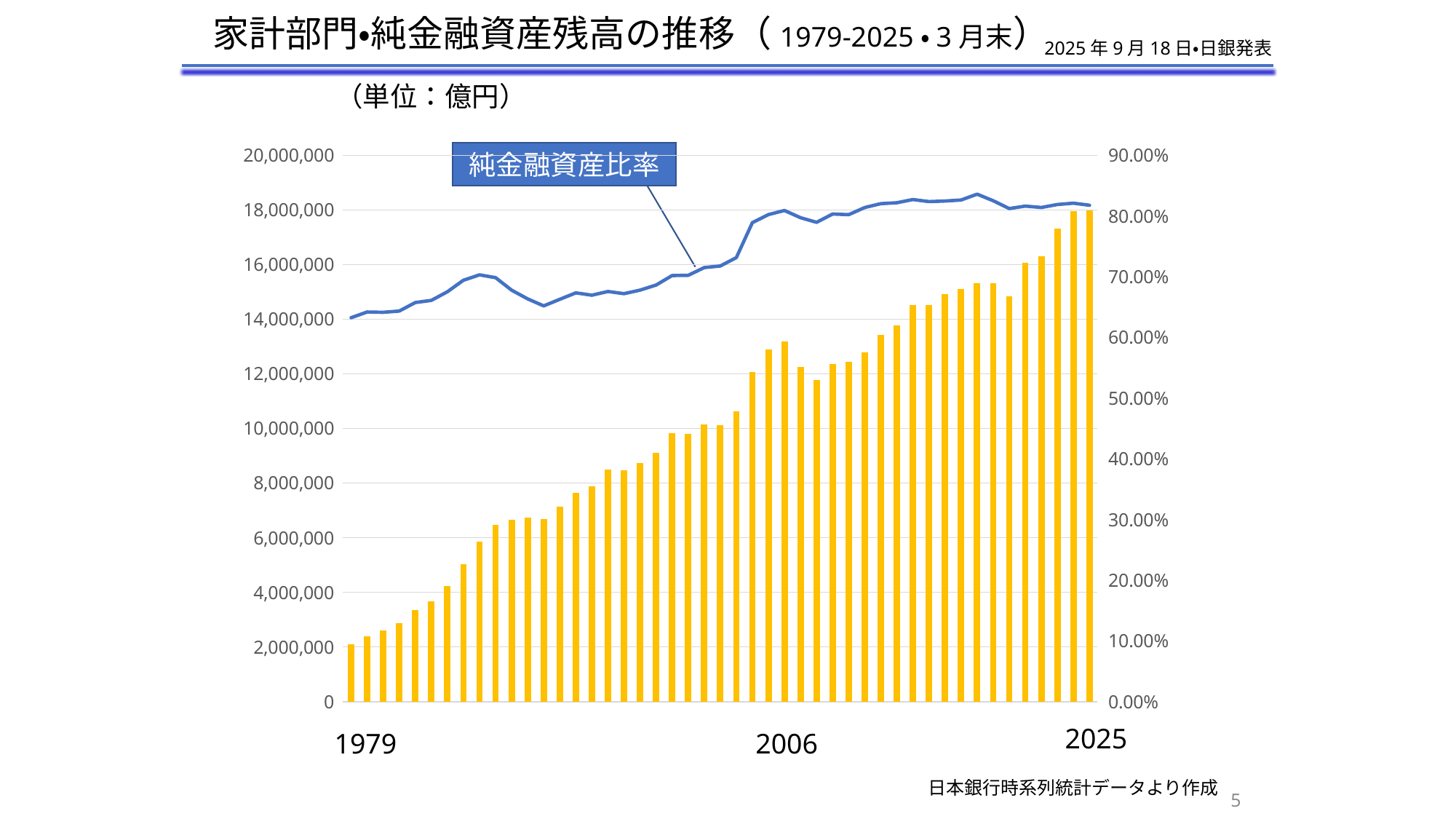
Is the bar value for 1979 greater or less than 4,000,000? less What kind of chart is shown on the slide? bar chart with a line How many years (bars) are plotted in the chart, covering 1979 to 2025? 47 What is the title of the chart? 家計部門•純金融資産残高の推移（1979-2025・3月末） Is the 純金融資産比率 line value for 2025 greater or less than 70.00%? greater Do the bar values generally rise or fall from 1979 to 2025? rise Which is larger, the bar value for 1979 or for 2025? 2025 Is the bar value for 2025 greater or less than 16,000,000? greater Which year has the lowest bar value? 1979 What label is attached to the line series in the chart? 純金融資産比率